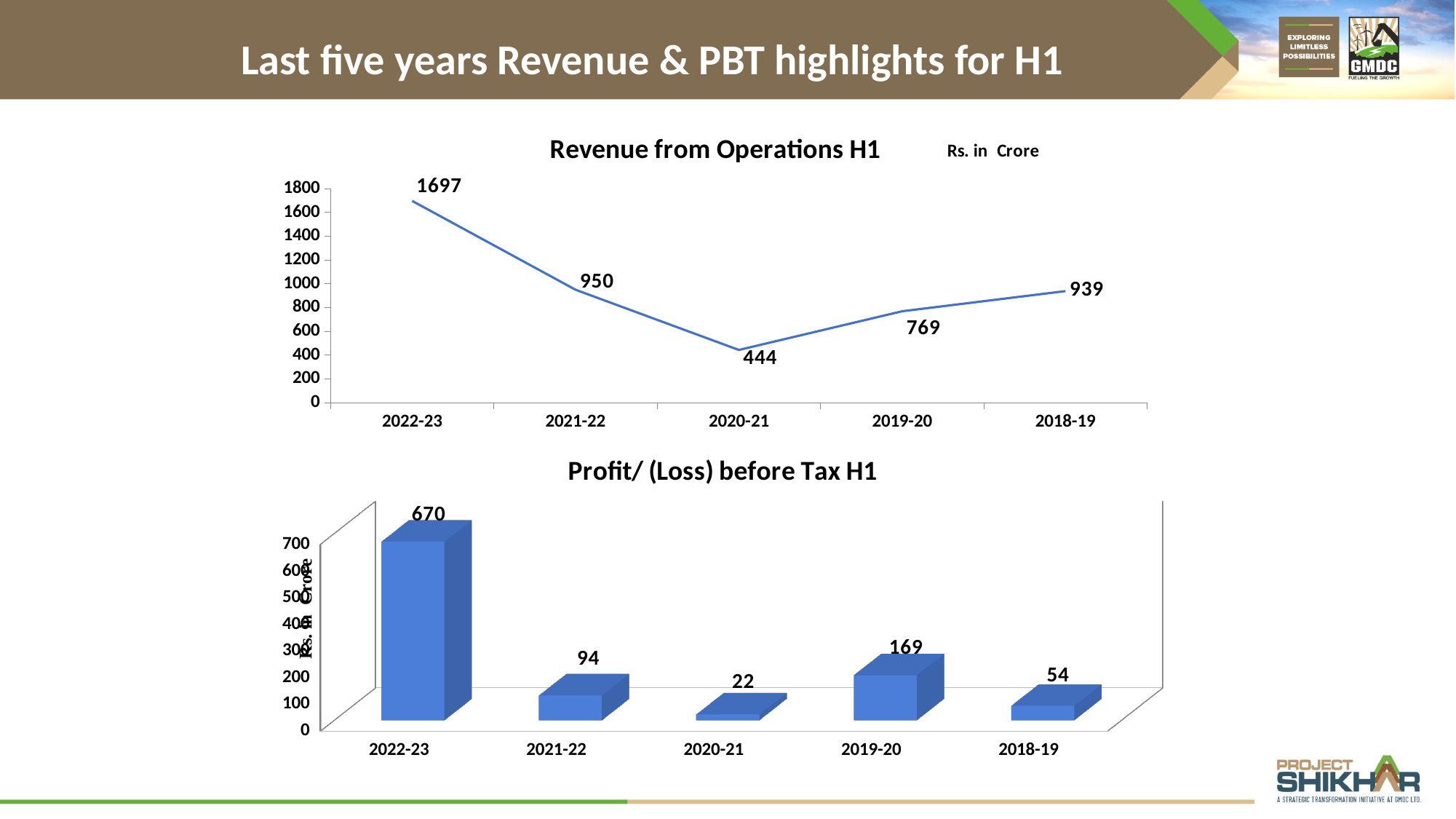
What kind of chart is the 'Revenue from Operations H1' chart? line chart What kind of chart is the 'Profit/ (Loss) before Tax H1' chart? bar chart In the 'Revenue from Operations H1' chart, which is larger, the value for 2019-20 or 2018-19? 2018-19 How many years are shown in the 'Profit/ (Loss) before Tax H1' chart? 5 In the 'Revenue from Operations H1' chart, what is the value for 2022-23? 1697 In the 'Profit/ (Loss) before Tax H1' chart, which year has the lowest value? 2020-21 In the 'Revenue from Operations H1' chart, what is the value for 2020-21? 444 In the 'Profit/ (Loss) before Tax H1' chart, what is the value for 2019-20? 169 In the 'Revenue from Operations H1' chart, which year has the lowest revenue? 2020-21 In the 'Profit/ (Loss) before Tax H1' chart, what is the difference between the values for 2022-23 and 2021-22? 576 In the 'Profit/ (Loss) before Tax H1' chart, which year has the highest value? 2022-23 In the 'Revenue from Operations H1' chart, what is the difference between the values for 2022-23 and 2021-22? 747